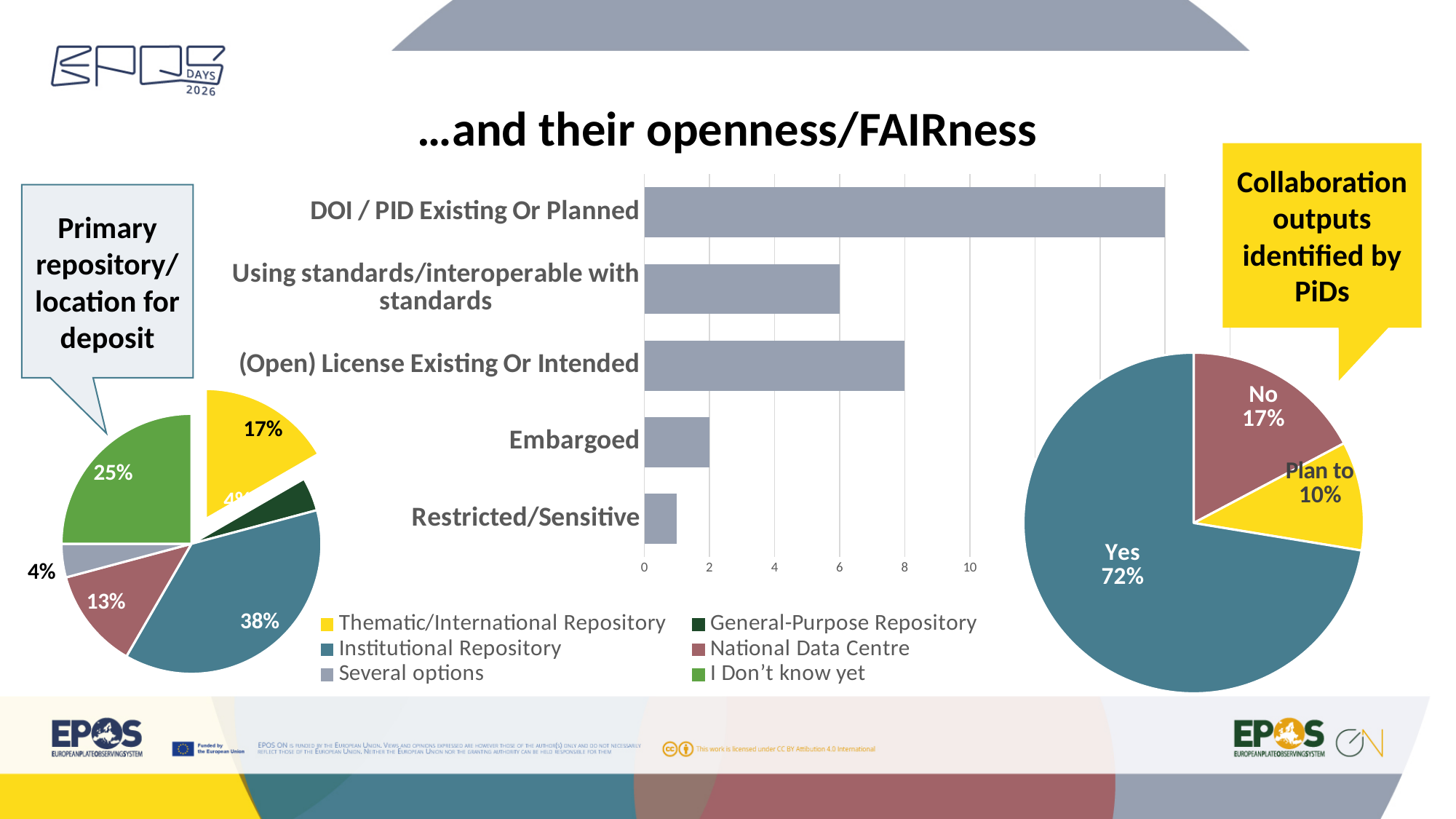
In the bar chart in the middle of the slide, which category has the lowest value? Restricted/Sensitive In the 'Collaboration outputs identified by PiDs' pie chart, what is the difference between the 'No' and 'Plan to' shares? 7% In the bar chart in the middle of the slide, what is the value for 'Using standards/interoperable with standards'? 6 In the 'Primary repository/location for deposit' pie chart, how many entries does the legend list? 6 In the bar chart in the middle of the slide, what is the value for 'Embargoed'? 2 In the 'Primary repository/location for deposit' pie chart, what share is Institutional Repository? 38% In the 'Collaboration outputs identified by PiDs' pie chart, what share is 'Yes'? 72% In the bar chart in the middle of the slide, which category has the highest value? DOI / PID Existing Or Planned In the 'Primary repository/location for deposit' pie chart, what share is 'I Don't know yet'? 25% In the bar chart in the middle of the slide, how many categories are shown? 5 In the bar chart in the middle of the slide, is the value for 'DOI / PID Existing Or Planned' greater or less than 10? greater In the bar chart in the middle of the slide, what is the value for '(Open) License Existing Or Intended'? 8